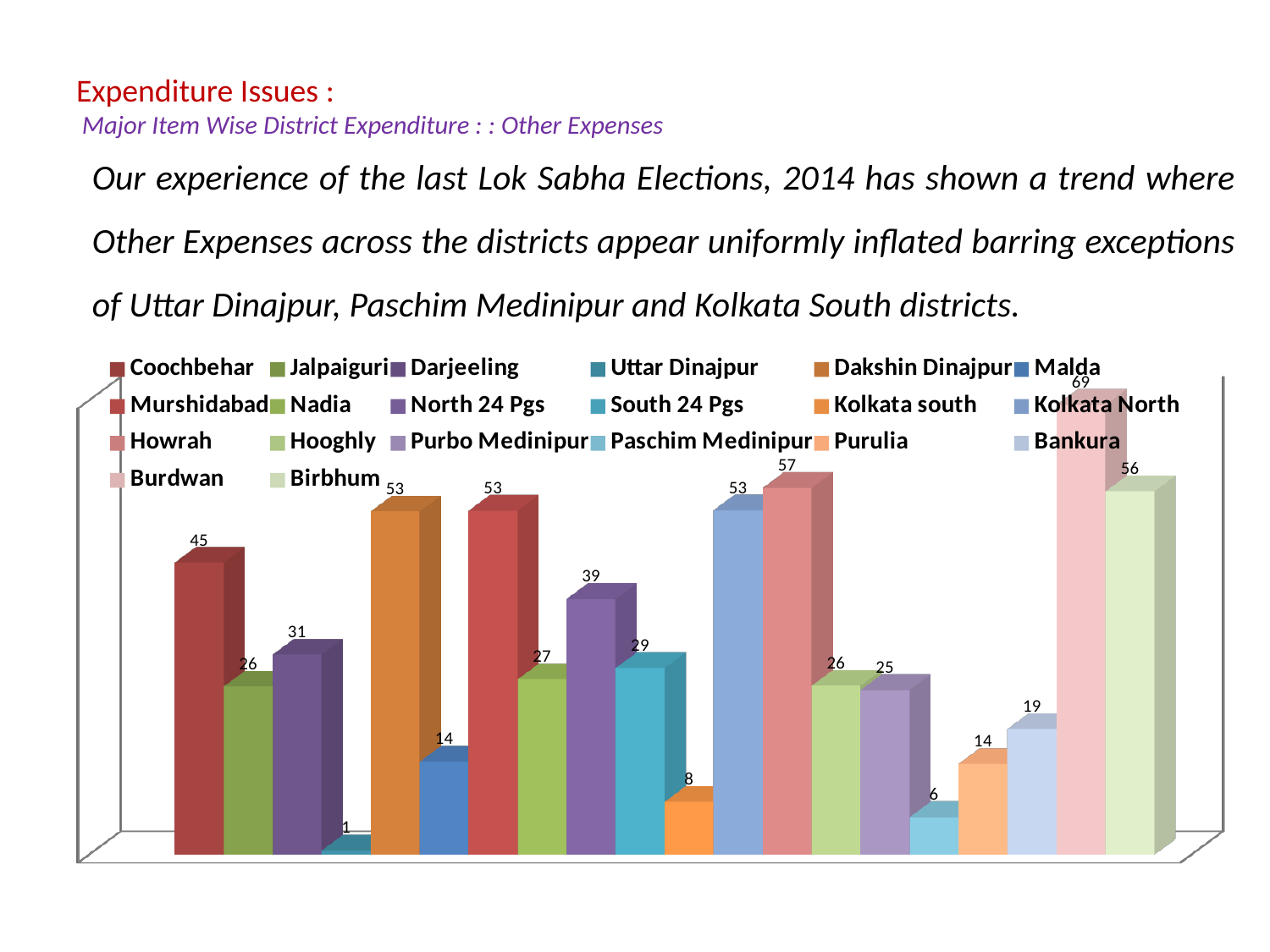
What is the value for Darjeeling? 31 Which district has the highest value? Burdwan What kind of chart is shown on the slide? Bar chart Which is larger, the value for Coochbehar or the value for North 24 Pgs? Coochbehar What is the value for Uttar Dinajpur? 1 What is the value for Kolkata south? 8 What is the difference between the values for Burdwan and Birbhum? 13 Which district has the lowest value? Uttar Dinajpur What is the value for Burdwan? 69 What is the value for Howrah? 57 What is the difference between the values for Paschim Medinipur and Purulia? 8 How many series does the legend list? 20